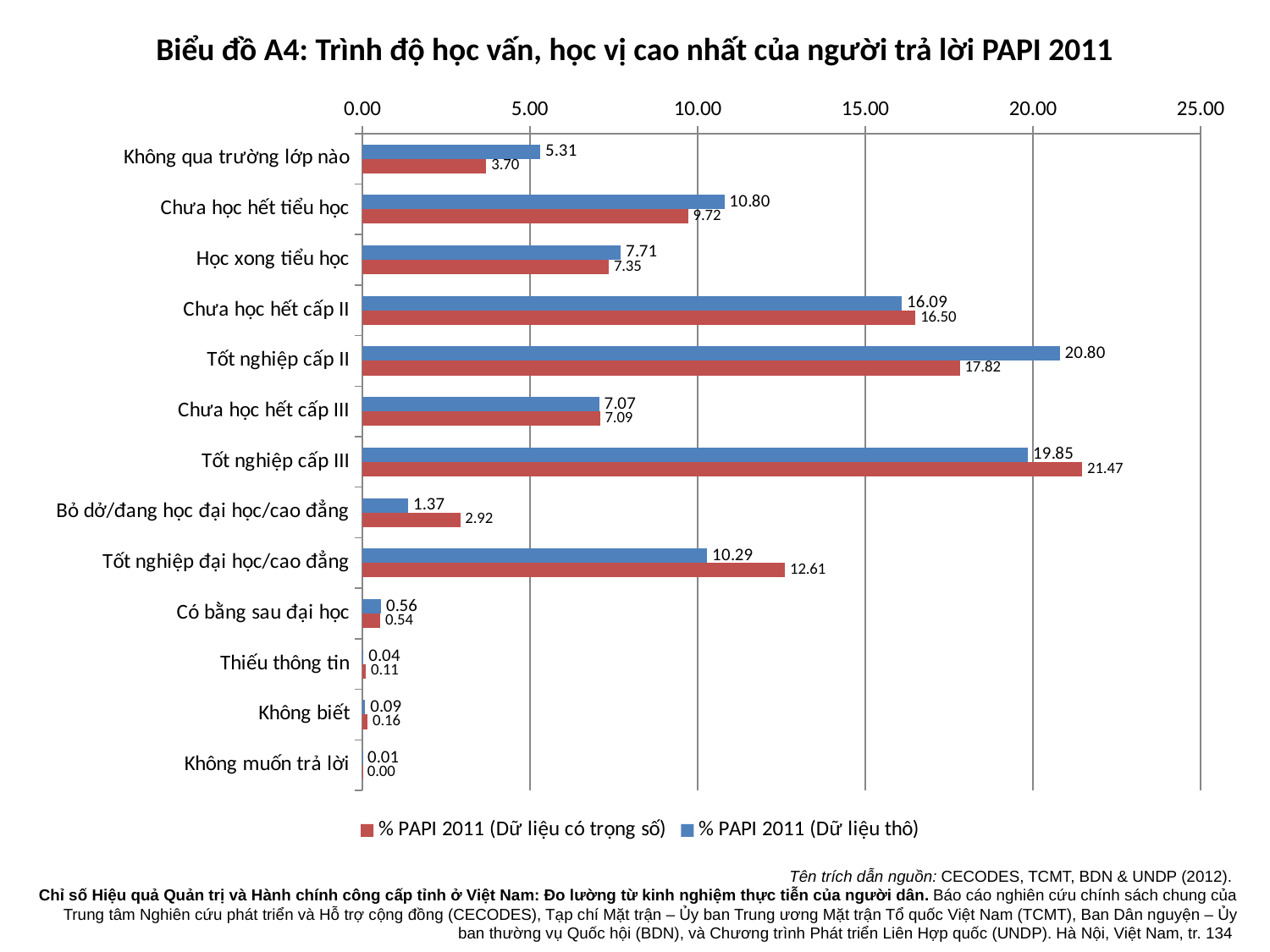
Which category has the highest value for "% PAPI 2011 (Dữ liệu có trọng số)"? Tốt nghiệp cấp III Which category has the lowest value for "% PAPI 2011 (Dữ liệu có trọng số)"? Không muốn trả lời What type of chart is shown on the slide? Bar chart Is the "% PAPI 2011 (Dữ liệu thô)" value for "Chưa học hết cấp II" greater or less than 15.00? greater Which category has the highest value for "% PAPI 2011 (Dữ liệu thô)"? Tốt nghiệp cấp II What is the difference between the "% PAPI 2011 (Dữ liệu thô)" and "% PAPI 2011 (Dữ liệu có trọng số)" values for "Tốt nghiệp cấp II"? 2.98 What is the value of "% PAPI 2011 (Dữ liệu thô)" for "Tốt nghiệp cấp II"? 20.80 What is the value of "% PAPI 2011 (Dữ liệu có trọng số)" for "Tốt nghiệp cấp III"? 21.47 How many series does the legend list? 2 What is the value of "% PAPI 2011 (Dữ liệu có trọng số)" for "Tốt nghiệp đại học/cao đẳng"? 12.61 How many categories are shown on the chart? 13 For "Bỏ dở/đang học đại học/cao đẳng", which series has the larger value: "% PAPI 2011 (Dữ liệu thô)" or "% PAPI 2011 (Dữ liệu có trọng số)"? % PAPI 2011 (Dữ liệu có trọng số)